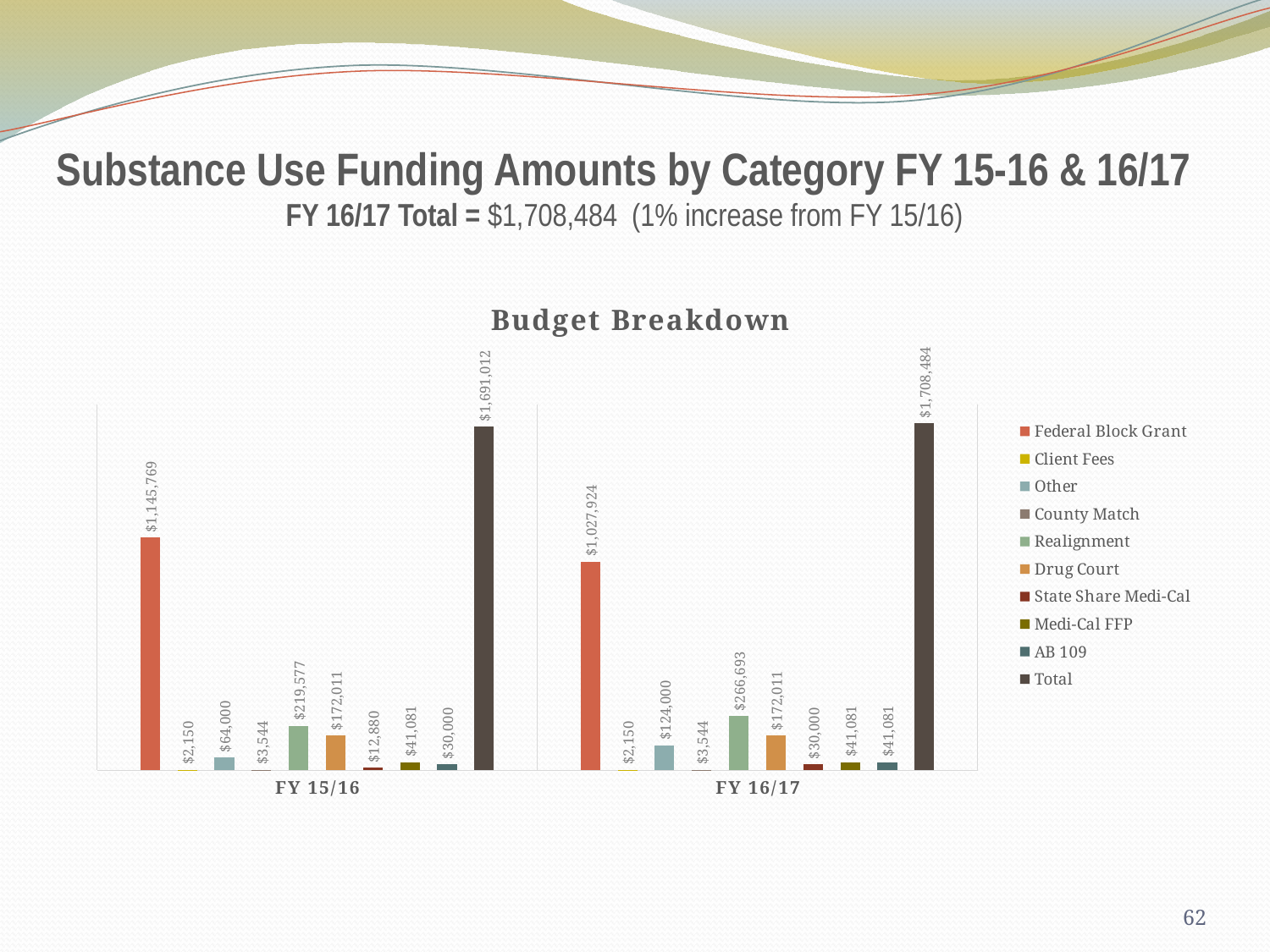
What is the State Share Medi-Cal value for FY 15/16 in the Budget Breakdown chart? $12,880 What is the difference between the Other values for FY 16/17 and FY 15/16 in the Budget Breakdown chart? $60,000 What is the value of the Federal Block Grant bar for FY 15/16 in the Budget Breakdown chart? $1,145,769 What type of chart is the Budget Breakdown chart? Bar chart How many fiscal year categories are shown on the x axis of the Budget Breakdown chart? 2 Is the Realignment value larger in FY 15/16 or FY 16/17 in the Budget Breakdown chart? FY 16/17 How many series does the legend of the Budget Breakdown chart list? 10 What is the Other value for FY 16/17 in the Budget Breakdown chart? $124,000 Which series has the lowest value for FY 16/17 in the Budget Breakdown chart? Client Fees How much did the Federal Block Grant decrease from FY 15/16 to FY 16/17 in the Budget Breakdown chart? $117,845 Excluding Total, which series has the highest value for FY 15/16 in the Budget Breakdown chart? Federal Block Grant What is the Realignment value for FY 16/17 in the Budget Breakdown chart? $266,693